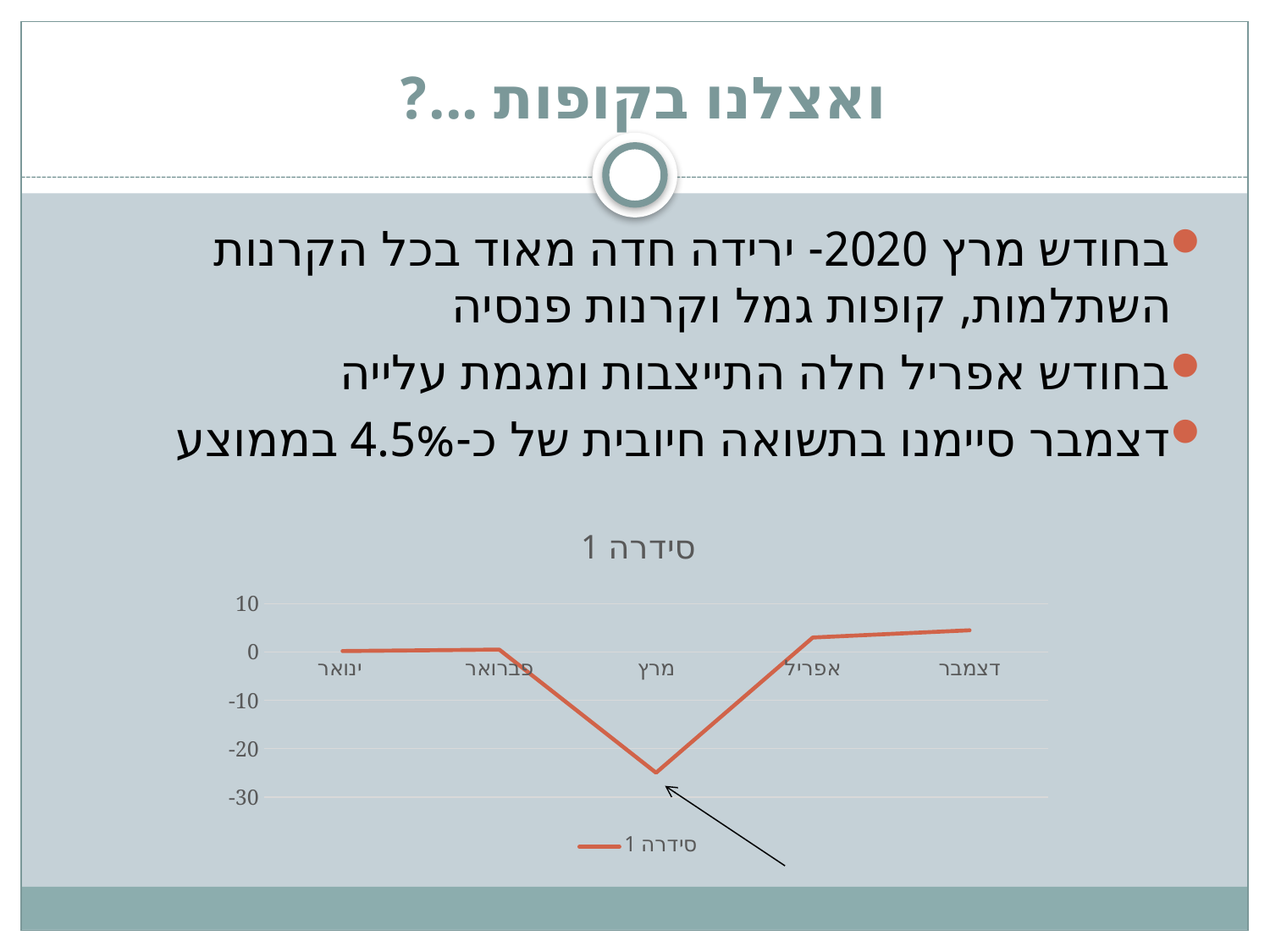
How many series does the chart legend list? 1 Is the value for דצמבר greater or less than 10? less Does the line rise or fall from פברואר to מרץ? fall How many categories are shown on the x axis of the chart? 5 Is the value for מרץ greater or less than -20? less Which category has the lowest value in the chart? מרץ Which has the larger value, מרץ or אפריל? אפריל What is the title of the chart? סידרה 1 Is the value for דצמבר greater or less than 0? greater Does the line rise or fall from מרץ to אפריל? rise What kind of chart is shown on the slide? line chart